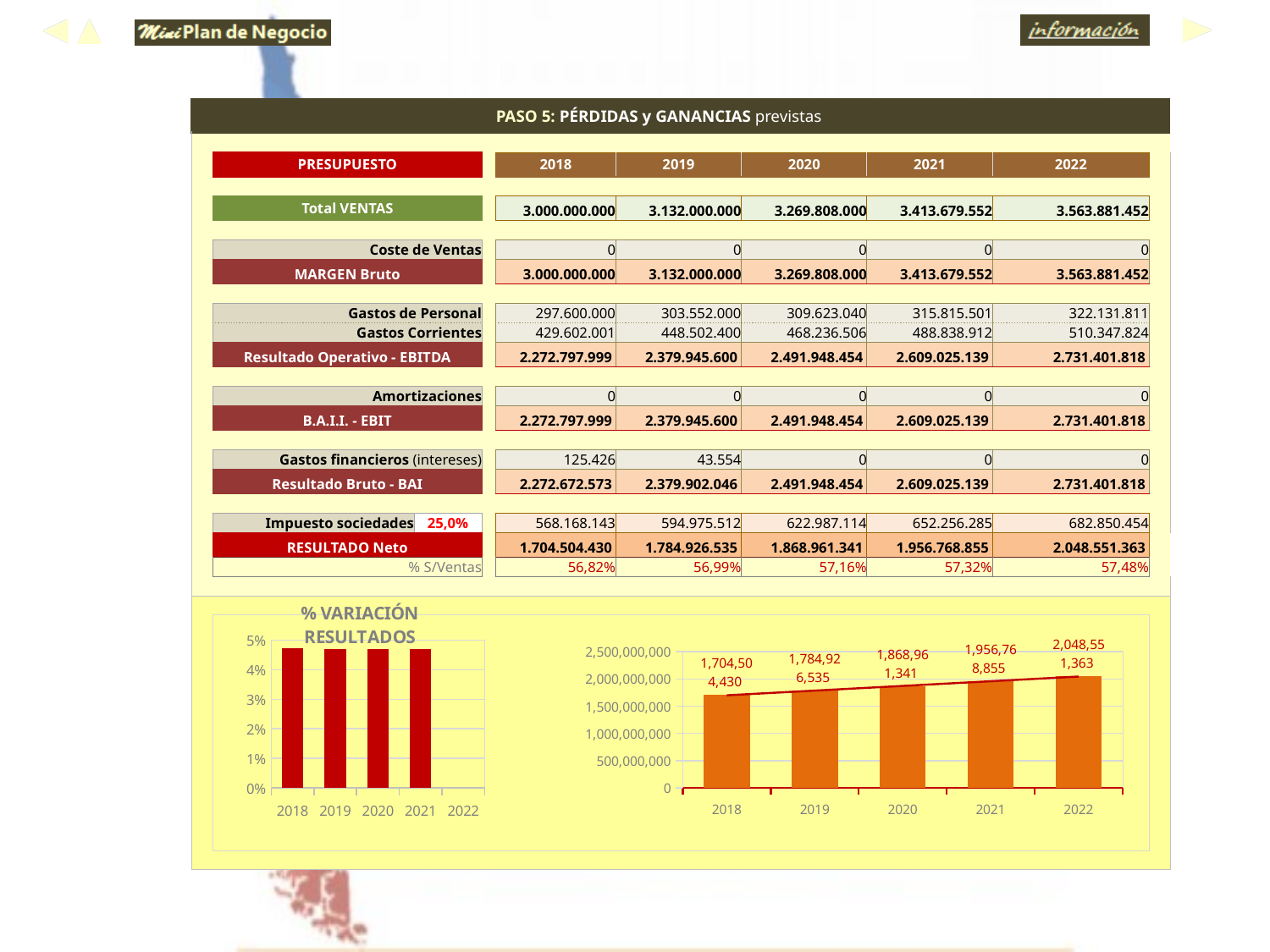
What kind of chart is the chart on the right of the slide? bar chart What is the title of the chart on the left of the slide? % VARIACIÓN RESULTADOS In the chart on the right, which year has the highest value? 2022 In the chart on the left, is the value for 2020 greater or less than 3%? greater In the chart on the right, do the values rise or fall from 2018 to 2022? rise In the chart on the right, what is the value for 2020? 1,868,961,341 In the chart on the right, which is larger, the value for 2021 or the value for 2019? 2021 In the chart on the right, what is the value for 2022? 2,048,551,363 How many years are shown on the x axis of the chart on the right? 5 In the chart on the right, which year has the lowest value? 2018 In the chart on the right, what is the difference between the values for 2022 and 2018? 344,046,933 In the chart on the right, what is the value for 2018? 1,704,504,430